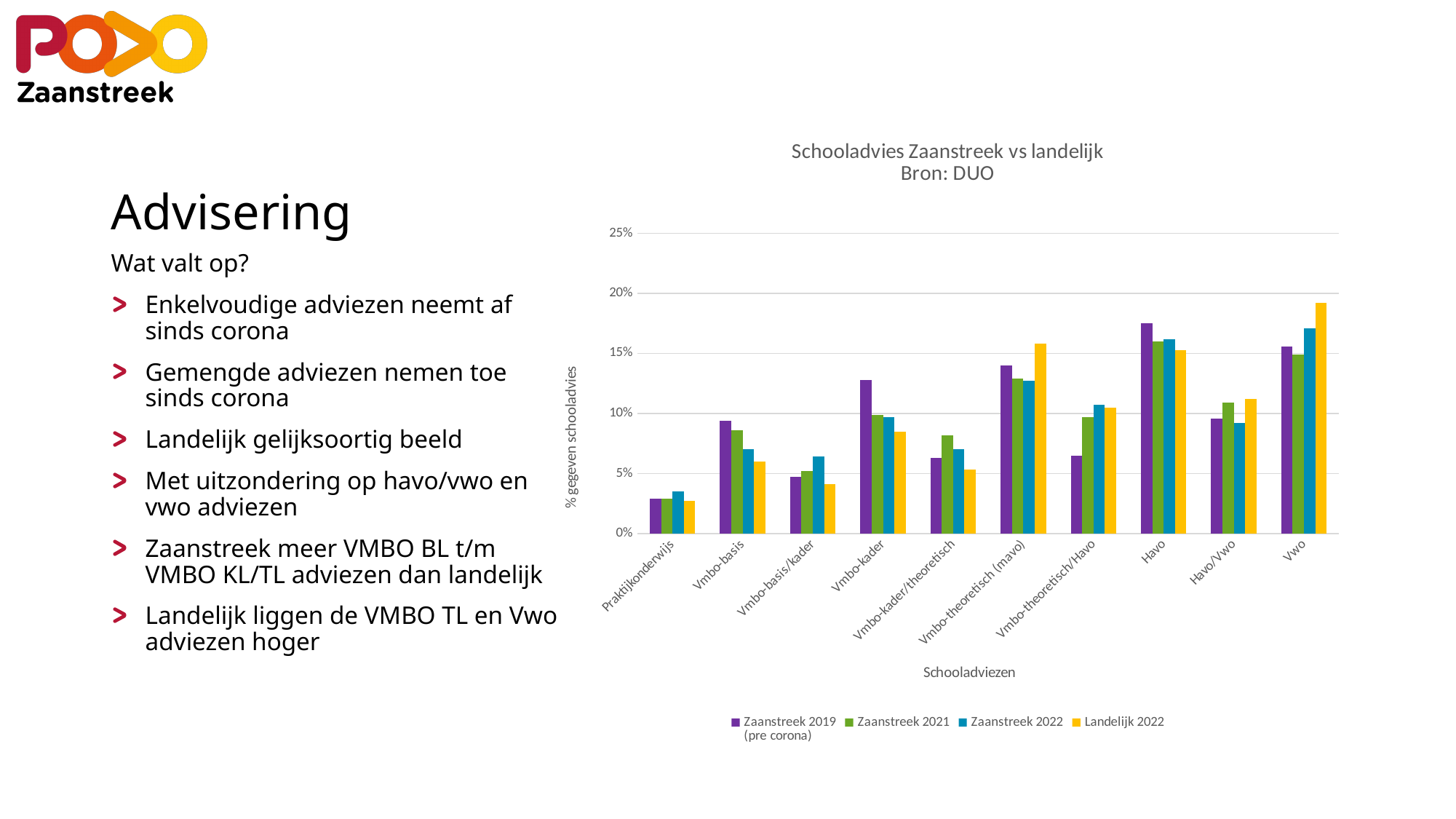
How many school advice categories are shown on the x axis of the chart? 10 Is the Landelijk 2022 value for Vmbo-basis greater or less than 10%? less How many series does the legend of the chart list? 4 What is the label of the vertical axis of the chart? % gegeven schooladvies For Vwo, which is larger: the Zaanstreek 2022 value or the Landelijk 2022 value? Landelijk 2022 For the Landelijk 2022 series, which category has the highest value? Vwo Is the Zaanstreek 2019 (pre corona) value for Havo greater or less than 15%? greater Is the Zaanstreek 2019 (pre corona) value for Vmbo-kader greater or less than 10%? greater For the Zaanstreek 2019 (pre corona) series, which category has the lowest value? Praktijkonderwijs What is the title of the chart? Schooladvies Zaanstreek vs landelijk Bron: DUO For Vmbo-basis, which is larger: the Zaanstreek 2019 (pre corona) value or the Landelijk 2022 value? Zaanstreek 2019 (pre corona) What kind of chart is shown on the slide? bar chart